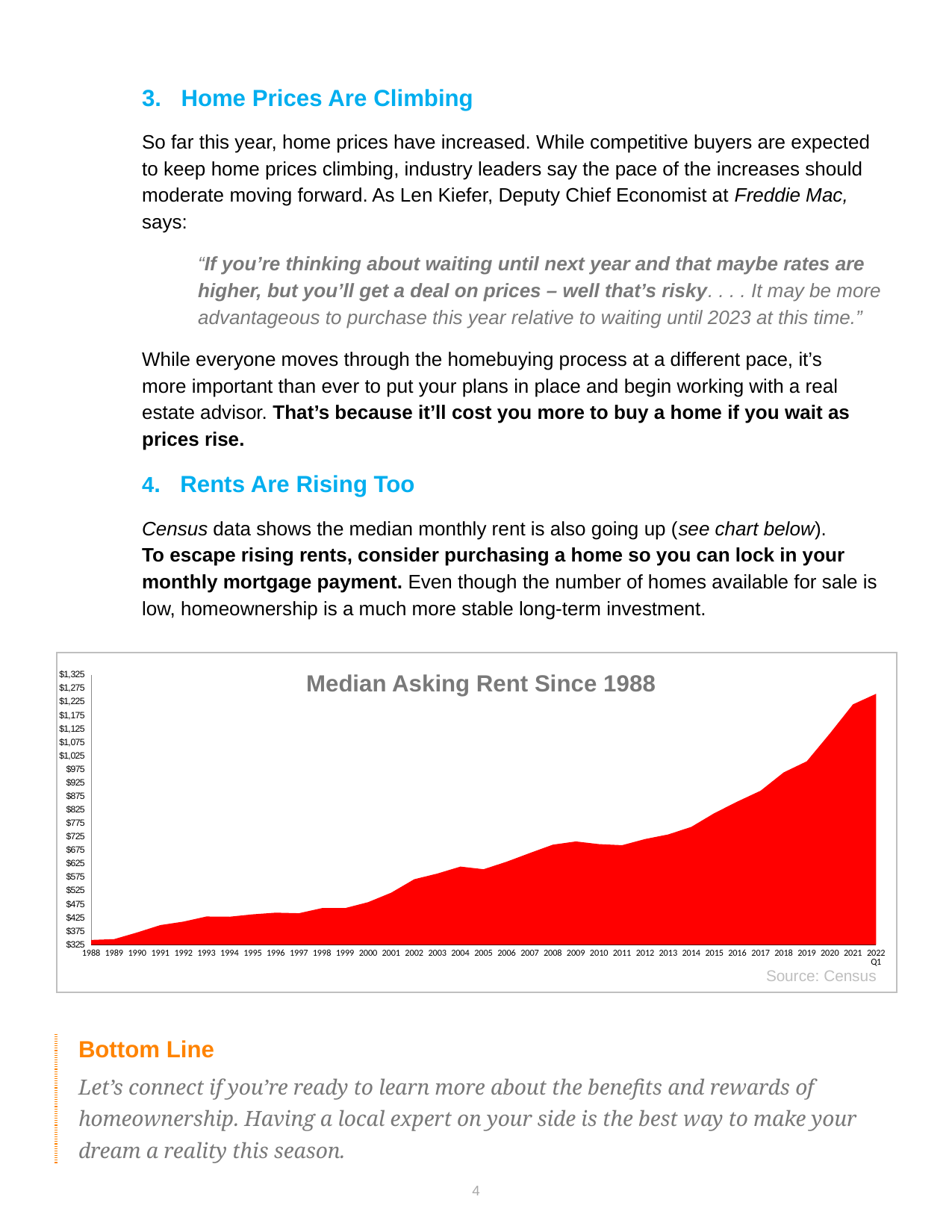
Which year on the x axis has the highest median asking rent? 2022 Q1 What kind of chart is shown on the slide? area chart Which year on the x axis has the lowest median asking rent? 1988 What is the title of the chart? Median Asking Rent Since 1988 What is the source cited for the chart? Census Is the median asking rent for 1988 greater or less than $375? less Is the median asking rent for 2022 Q1 greater or less than $1,175? greater Which has the higher median asking rent, 2003 or 2013? 2013 Do the median asking rent values generally rise or fall from 1988 to 2022 Q1? rise Is the median asking rent for 2017 greater or less than $825? greater